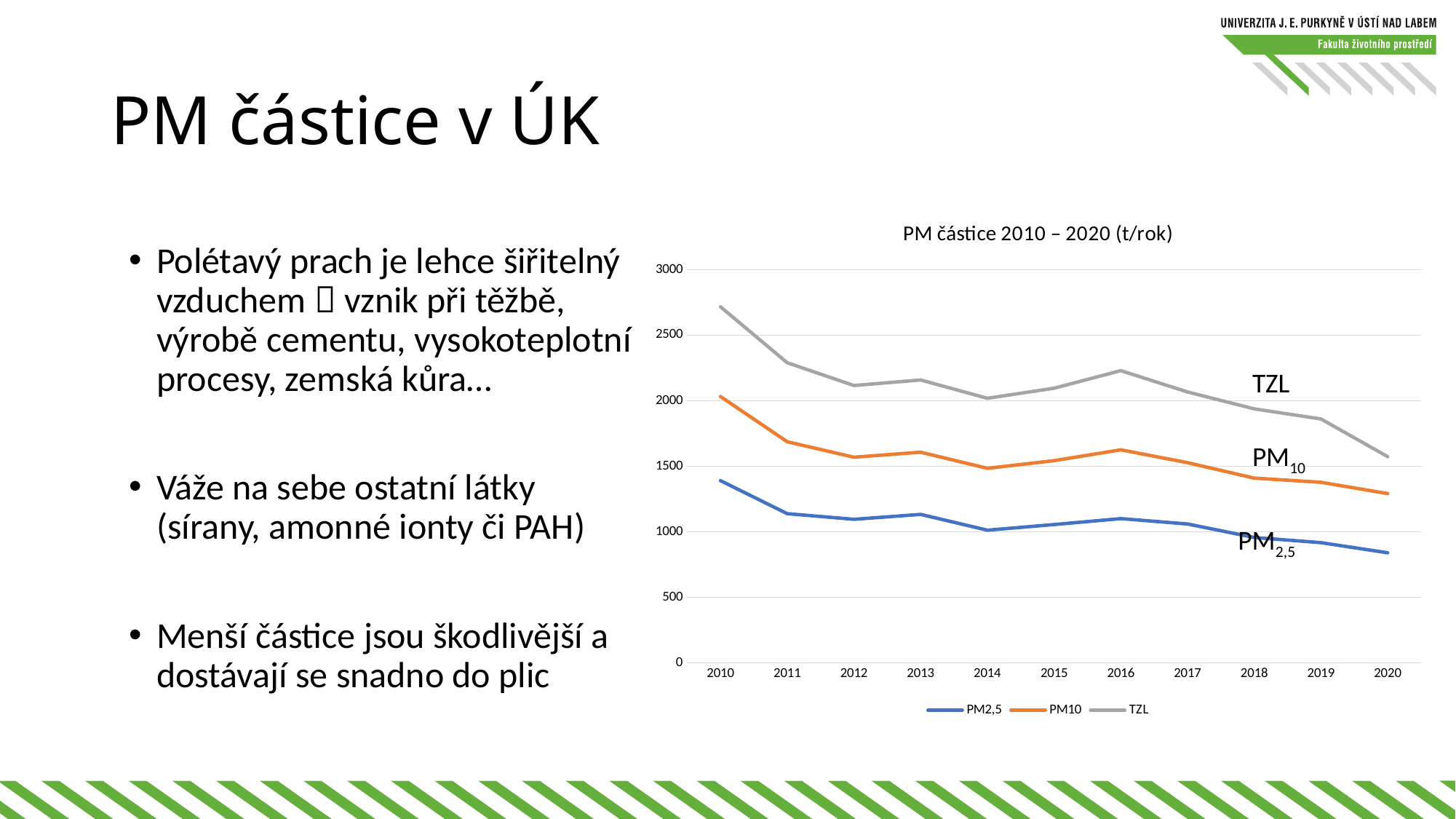
Which series has the highest values across all years? TZL In which year is the TZL value highest? 2010 Is the TZL value for 2010 greater or less than 2500? greater What is the title of the chart? PM částice 2010 – 2020 (t/rok) In which year is the PM2,5 value lowest? 2020 Which is larger in 2015, the TZL value or the PM10 value? TZL What kind of chart is shown on the slide? line chart How many years are plotted along the x axis of the chart? 11 How many series does the legend of the chart list? 3 Which series is plotted with the orange line? PM10 Do the TZL values generally rise or fall from 2010 to 2020? fall Is the PM2,5 value for 2020 greater or less than 1000? less